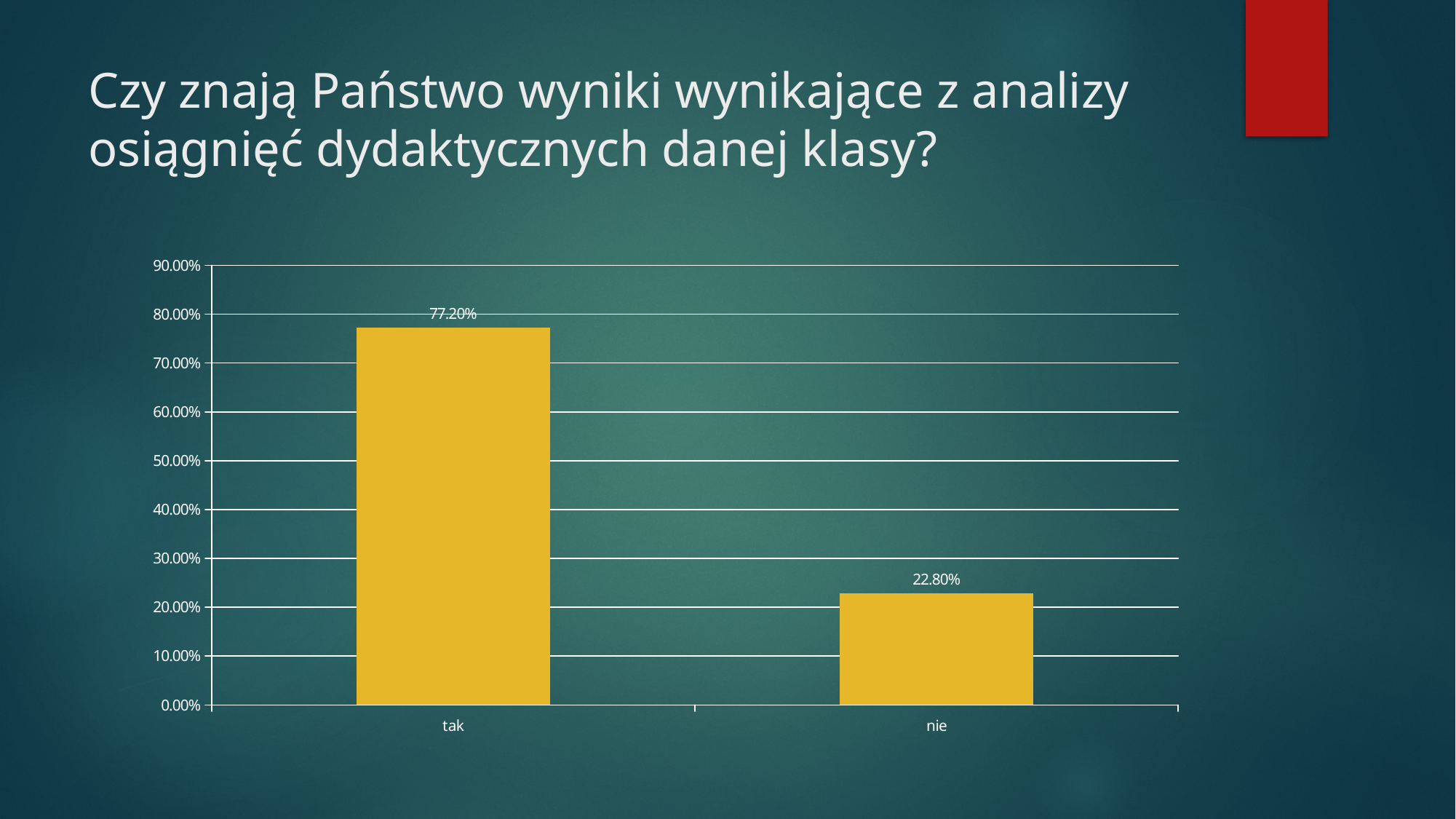
What kind of chart is shown on the slide? bar chart What is the difference between the values for "tak" and "nie"? 54.40% Which category has the lowest value? nie Is the value for "tak" greater or less than 70.00%? greater Which is larger, the value for "tak" or the value for "nie"? tak Is the value for "nie" greater or less than 30.00%? less What is the highest value shown on the y axis? 90.00% How many categories are shown on the x axis? 2 What is the value for "tak"? 77.20% What is the value for "nie"? 22.80% What colour are the bars in the chart? yellow Which category has the highest value? tak